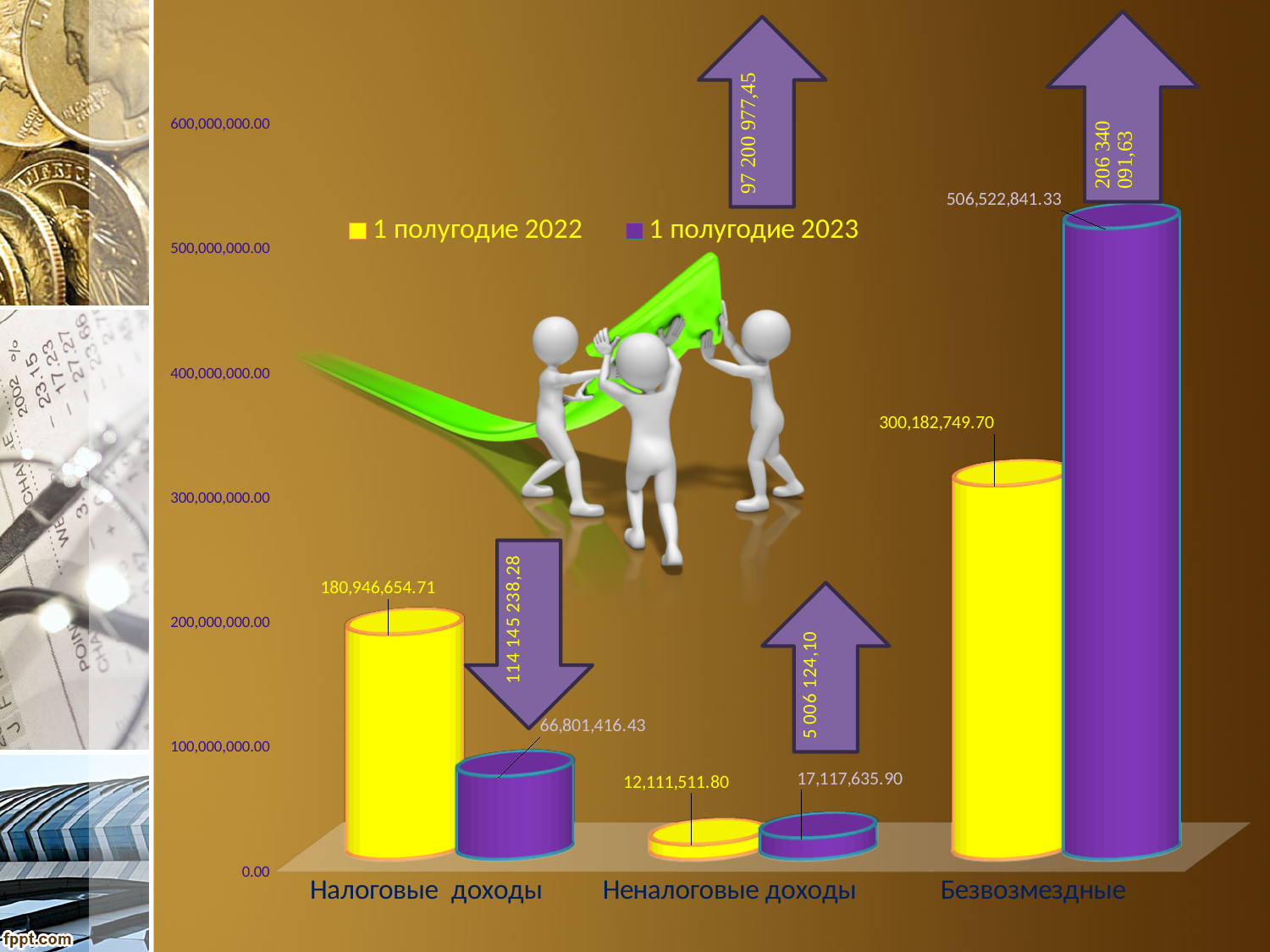
What is the value for Неналоговые доходы in the 1 полугодие 2023 series? 17,117,635.90 Which category has the lowest value in the 1 полугодие 2022 series? Неналоговые доходы What is the value for Налоговые доходы in the 1 полугодие 2022 series? 180,946,654.71 How many series does the legend list? 2 What is the value for Налоговые доходы in the 1 полугодие 2023 series? 66,801,416.43 What kind of chart is shown on the slide? bar chart For Налоговые доходы, which series has the larger value, 1 полугодие 2022 or 1 полугодие 2023? 1 полугодие 2022 How many categories are shown on the x axis? 3 What is the value for Безвозмездные in the 1 полугодие 2022 series? 300,182,749.70 Which category has the highest value in the 1 полугодие 2023 series? Безвозмездные Is the value for Безвозмездные in the 1 полугодие 2023 series greater or less than 500,000,000.00? greater What is the difference between the 1 полугодие 2023 and 1 полугодие 2022 values for Безвозмездные? 206,340,091.63